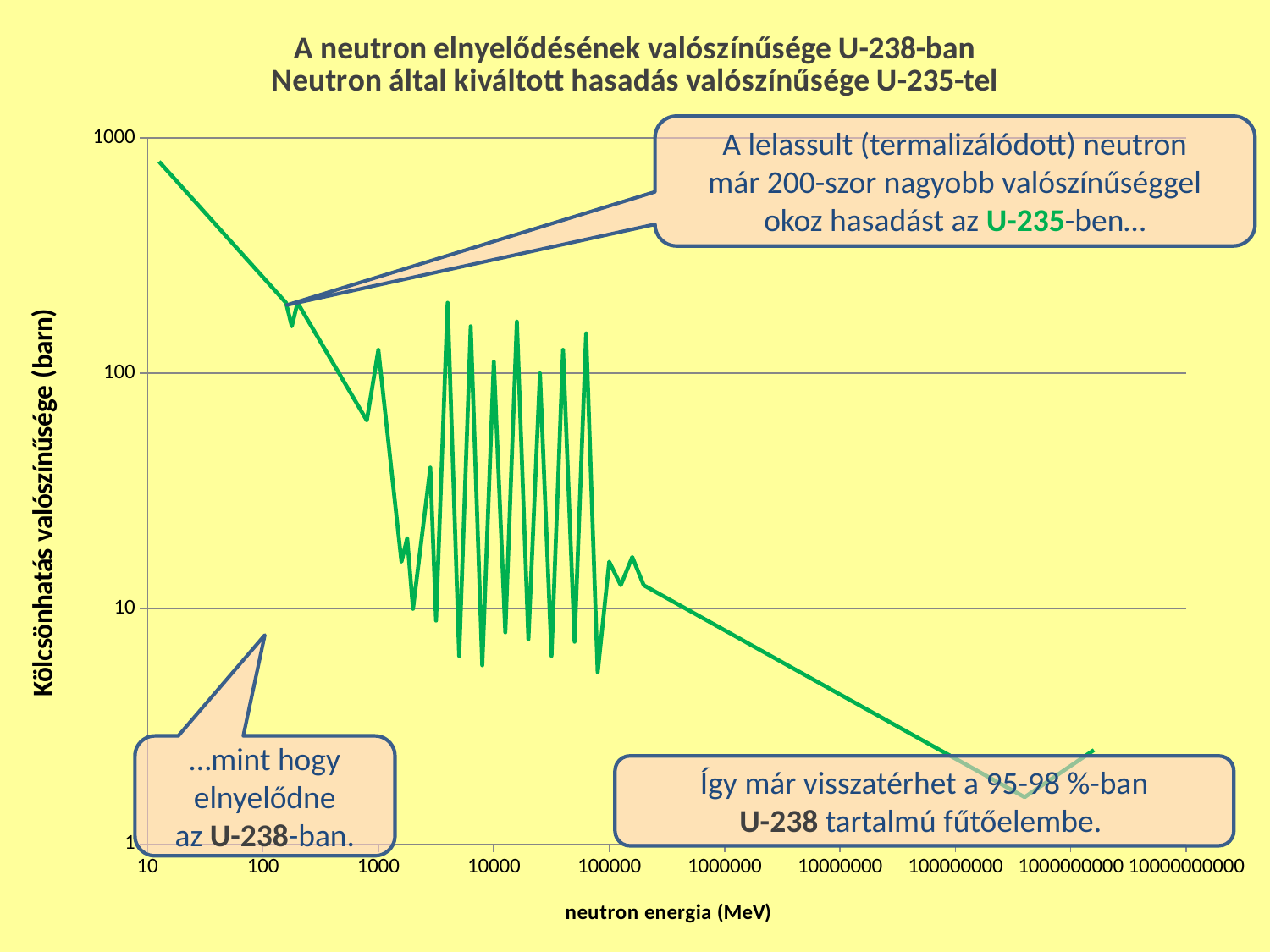
Is the value of the line at a neutron energy of 10 MeV greater or less than 100 barn? greater Which is larger: the value of the line at 10 MeV or at 1000000 MeV? 10 MeV Is the value of the line at a neutron energy of 1000000 MeV greater or less than 100 barn? less What is the label of the x axis of the chart? neutron energia (MeV) What is the highest value shown on the y axis of the chart? 1000 Is the value of the line at a neutron energy of 100000000 MeV greater or less than 10 barn? less What kind of chart is shown on the slide? line chart Does the line generally rise or fall as neutron energy increases from 10 MeV to 100000000 MeV? fall What is the label of the y axis of the chart? Kölcsönhatás valószínűsége (barn)